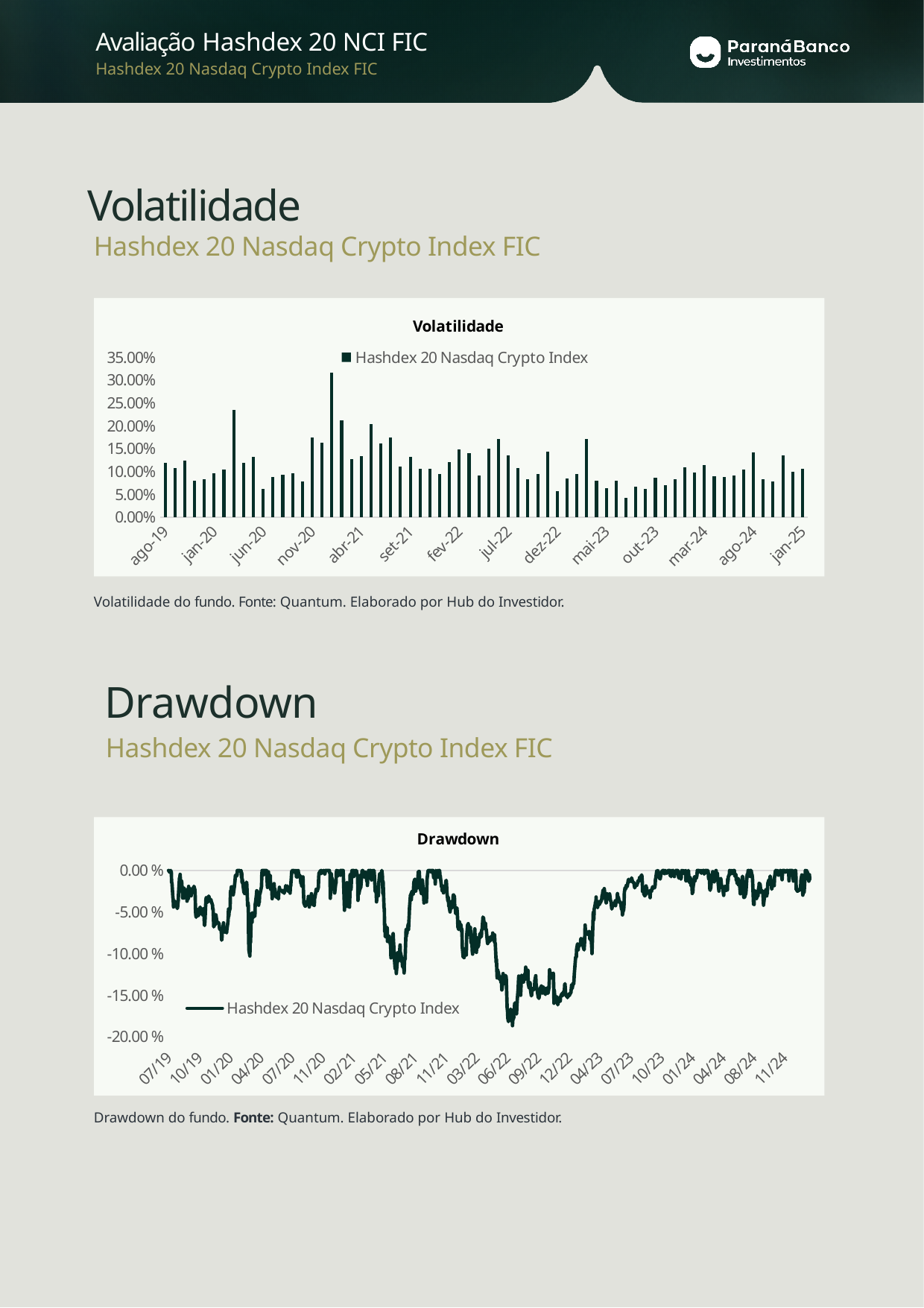
What is the lowest value shown on the vertical axis of the Drawdown chart? -20.00 % In the Volatilidade chart, is the highest bar greater or less than 25.00%? greater What series name is shown in the legend of the Drawdown chart? Hashdex 20 Nasdaq Crypto Index In the Drawdown chart, is the lowest point of the line greater or less than -15.00 %? less In the Volatilidade chart, is the value for out-23 greater or less than 10.00%? less In the Volatilidade chart, which is larger, the value for nov-20 or the value for jun-20? nov-20 What kind of chart is the Volatilidade chart? bar chart How many series does the legend of the Volatilidade chart list? 1 What kind of chart is the Drawdown chart? line chart